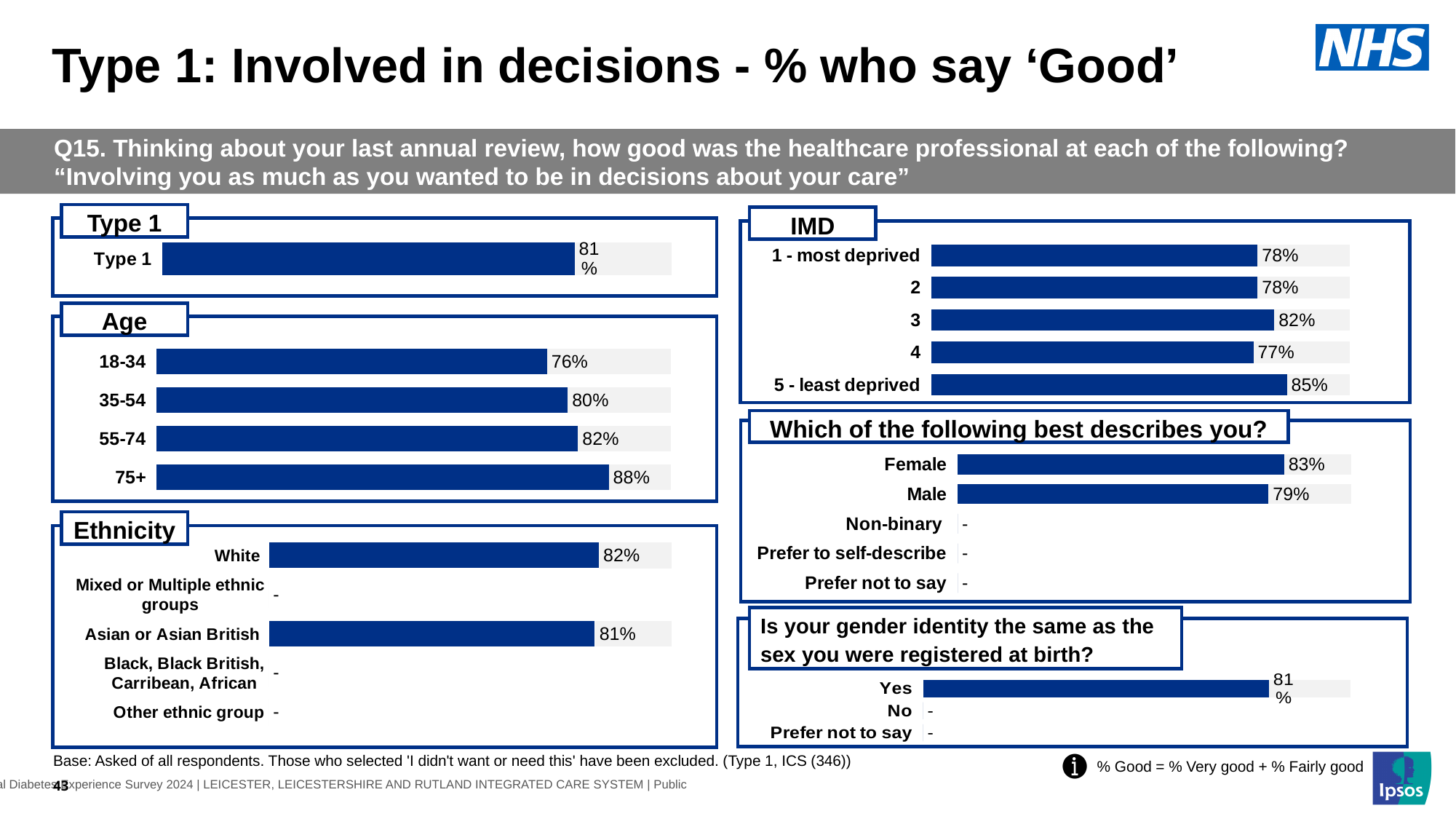
In the 'Which of the following best describes you?' chart, what is the value for Female? 83% What kind of chart is used in the Age section? Bar chart In the Ethnicity chart, what is the value for Asian or Asian British? 81% In the IMD chart, which category has the highest value? 5 - least deprived In the Age chart, which age group has the lowest value? 18-34 In the 'Is your gender identity the same as the sex you were registered at birth?' chart, what is the value for Yes? 81% In the Ethnicity chart, which is larger: White or Asian or Asian British? White In the Age chart, what is the value for the 75+ group? 88% In the IMD chart, how many categories are shown? 5 In the IMD chart, what is the value for category 4? 77% In the Age chart, what is the difference between the 75+ and 18-34 values? 12 percentage points In the 'Which of the following best describes you?' chart, what is the difference between the Female and Male values? 4 percentage points